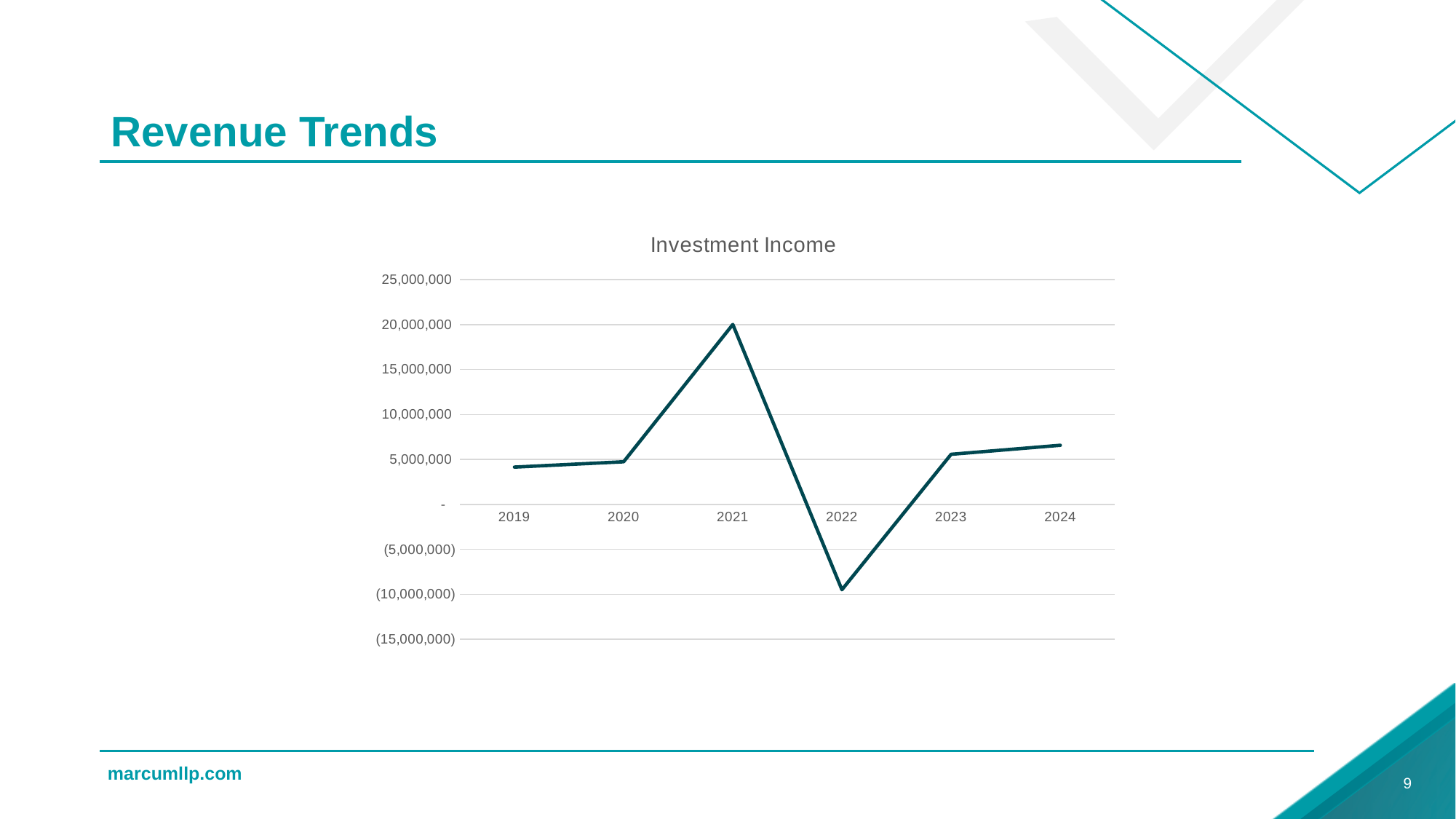
Which year has the highest Investment Income? 2021 What is the title of the chart? Investment Income Does Investment Income rise or fall from 2021 to 2022? fall Does Investment Income rise or fall from 2022 to 2024? rise Is the Investment Income for 2019 greater or less than 5,000,000? less Is the Investment Income for 2021 greater or less than 15,000,000? greater Which year has the lowest Investment Income? 2022 How many years are plotted on the x axis of the Investment Income chart? 6 What kind of chart is shown on the slide? line chart Is the Investment Income for 2024 greater or less than 5,000,000? greater Which year has the larger Investment Income, 2020 or 2021? 2021